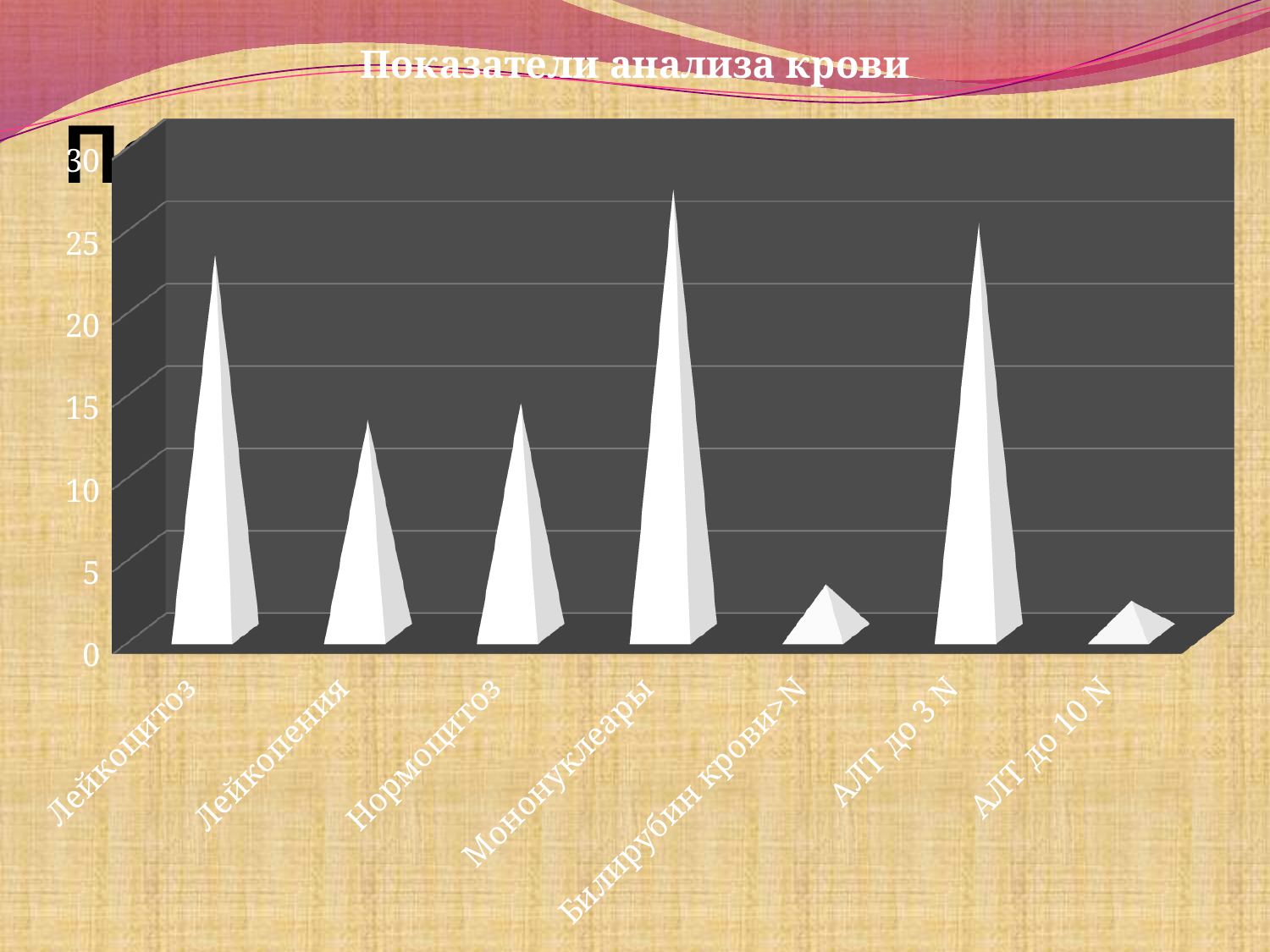
Is the value for АЛТ до 3 N greater or less than 20? greater Which category has the highest value in the chart? Мононуклеары Is the value for АЛТ до 10 N greater or less than 5? less What is the title of the chart? Показатели анализа крови Which is larger, the value for Лейкоцитоз or the value for Лейкопения? Лейкоцитоз Is the value for Лейкопения greater or less than 15? less What kind of chart is shown on the slide? bar chart Which is larger, the value for Нормоцитоз or the value for Мононуклеары? Мононуклеары How many categories are shown on the x axis of the chart? 7